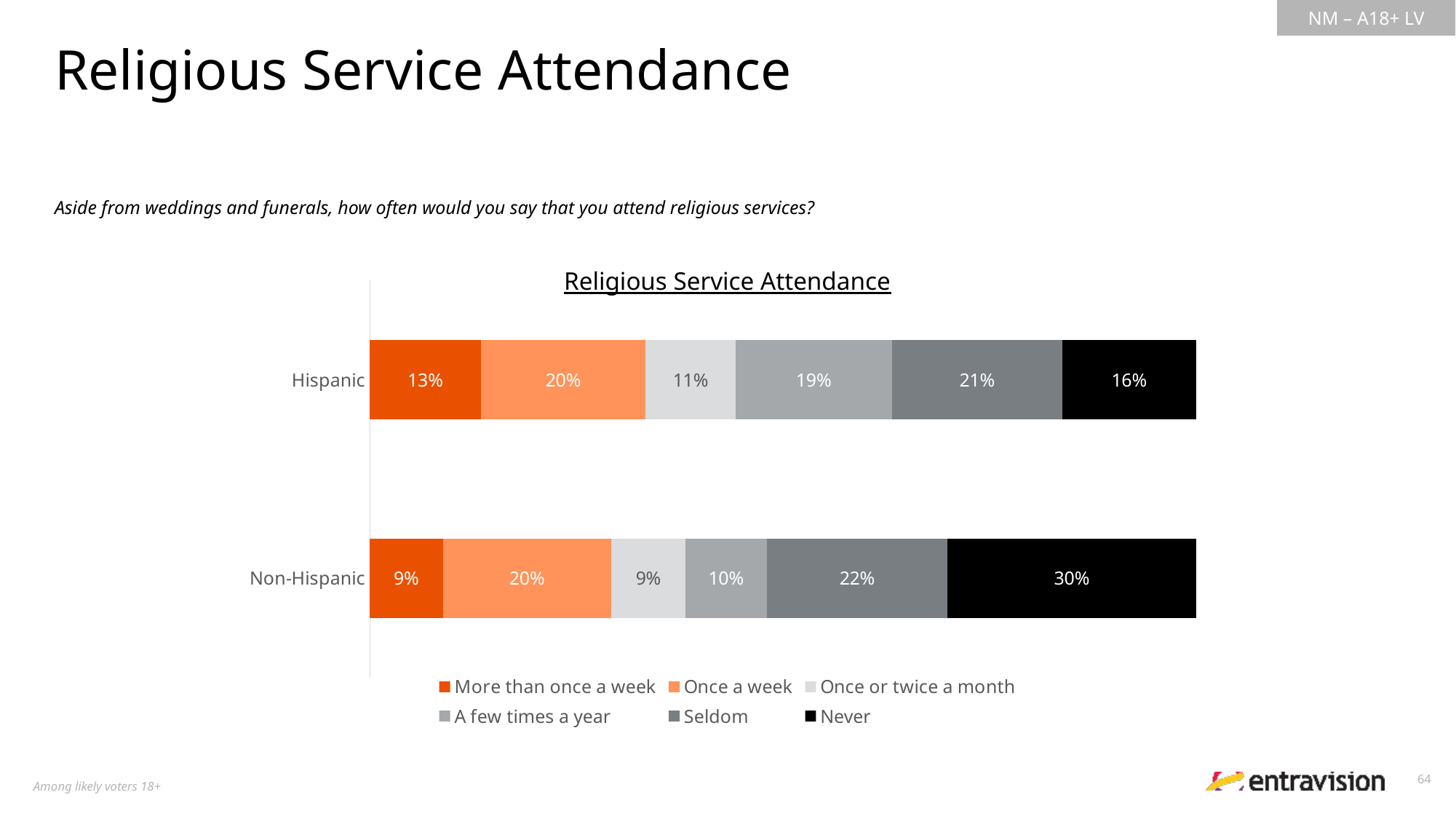
What is the difference between the Non-Hispanic and Hispanic 'Never' values? 14 percentage points Which response category has the lowest value for Hispanic respondents? Once or twice a month What percentage of Non-Hispanic respondents say they never attend religious services? 30% How many groups (bars) are shown in the chart? 2 Which response category has the highest value for Non-Hispanic respondents? Never What percentage of Hispanic respondents attend religious services more than once a week? 13% What is the value for 'Seldom' among Hispanic respondents? 21% How many series does the legend list? 6 Which group has a higher value for 'A few times a year', Hispanic or Non-Hispanic? Hispanic What colour represents the 'Never' category in the chart? Black What is the value for 'A few times a year' among Non-Hispanic respondents? 10% What type of chart is shown on the slide? Stacked bar chart